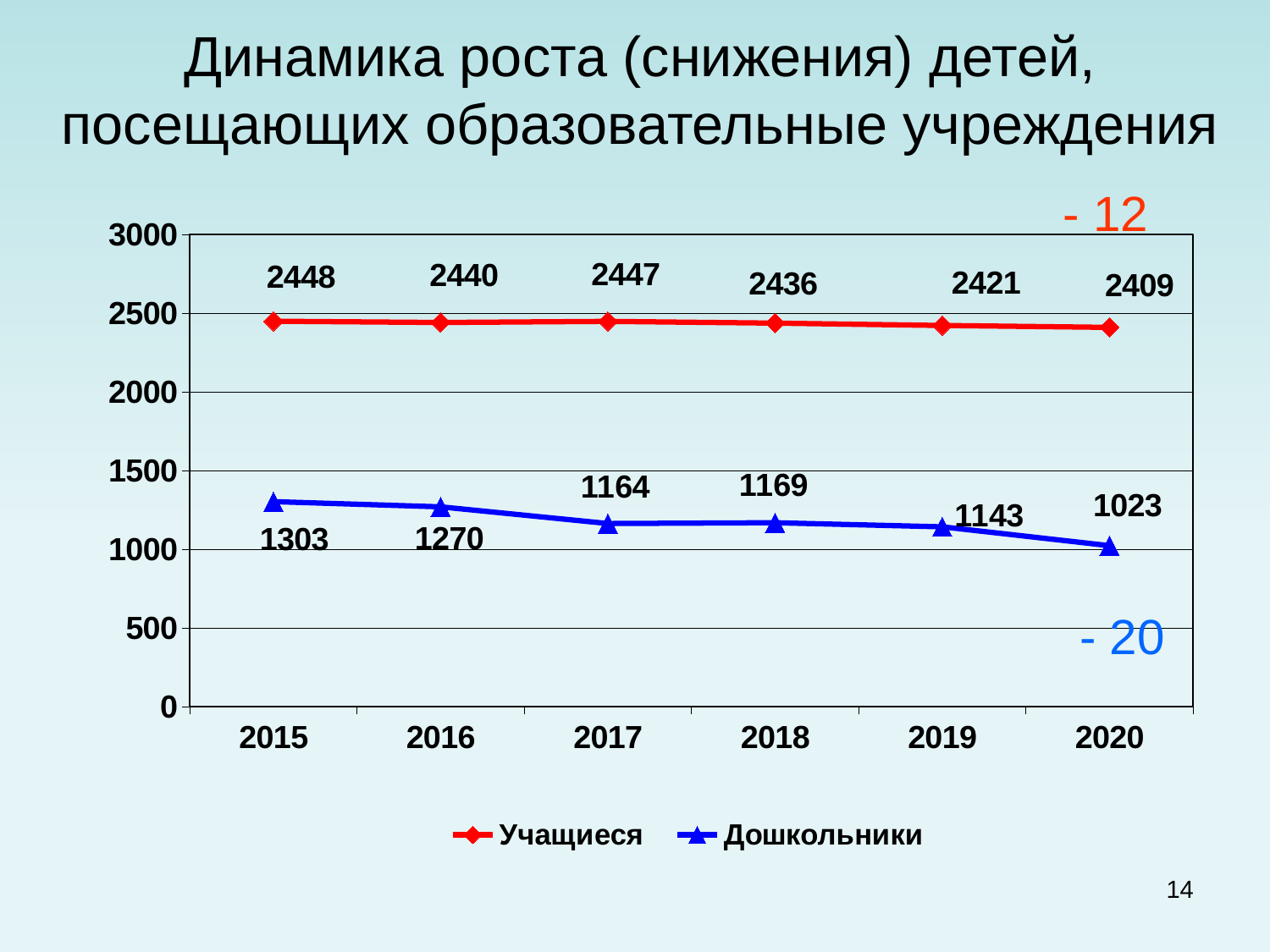
Is the value for Дошкольники in 2017 greater or less than 1500? less In which year is the value for Учащиеся highest? 2015 What is the difference between the Учащиеся values in 2015 and 2020? 39 In which year is the value for Дошкольники lowest? 2020 How many years are shown on the x axis? 6 Which is larger, the Дошкольники value in 2016 or in 2019? 2016 What is the value for Учащиеся in 2015? 2448 How many series does the legend list? 2 What is the difference between the Дошкольники values in 2015 and 2020? 280 What is the value for Дошкольники in 2020? 1023 What kind of chart is shown on the slide? line chart What is the value for Дошкольники in 2018? 1169